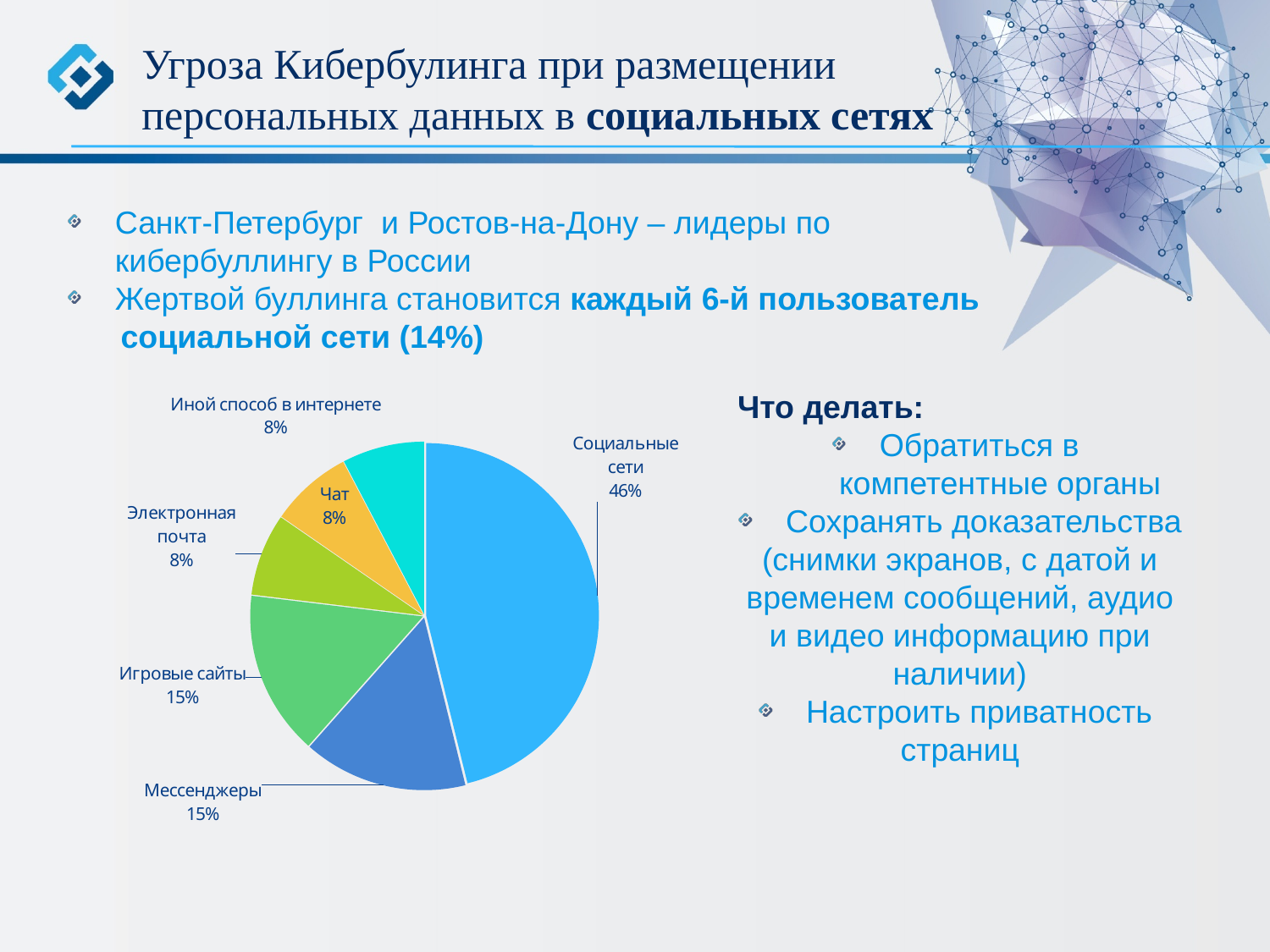
What kind of chart is shown on the slide? pie chart What is the value shown for "Игровые сайты" in the pie chart? 15% What is the difference between the values for "Игровые сайты" and "Электронная почта" in the pie chart? 7% Which category has the largest slice in the pie chart? Социальные сети What is the value shown for "Чат" in the pie chart? 8% What is the value shown for "Мессенджеры" in the pie chart? 15% What is the value shown for "Иной способ в интернете" in the pie chart? 8% What share of the pie chart does "Социальные сети" have? 46% What is the difference between the values for "Социальные сети" and "Мессенджеры" in the pie chart? 31% Which is larger in the pie chart, "Игровые сайты" or "Чат"? Игровые сайты What is the value shown for "Электронная почта" in the pie chart? 8% How many slices does the pie chart have? 6